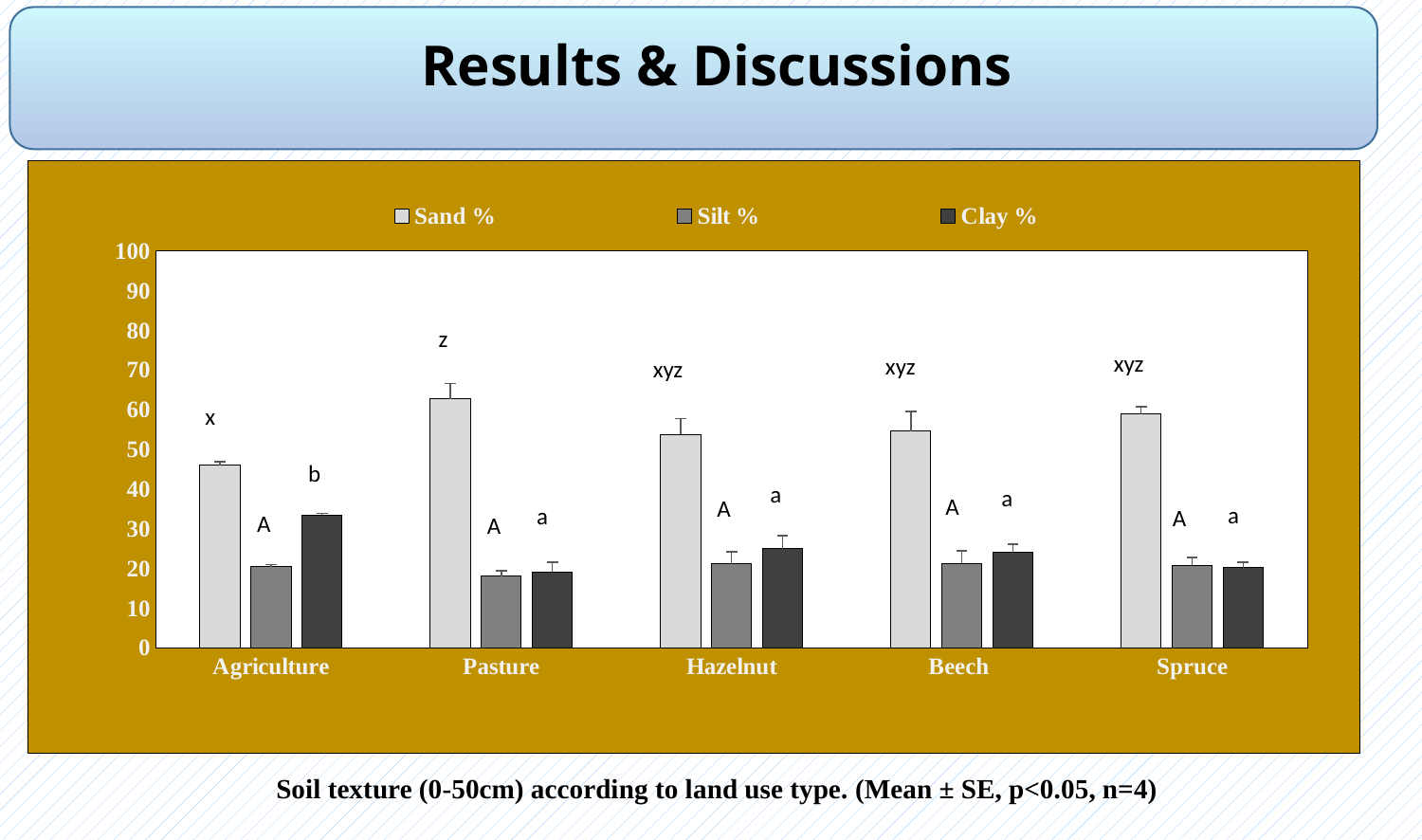
Which land use type has the lowest Sand % bar? Agriculture How many land use types are shown on the x axis of the chart? 5 Is the Sand % value for Pasture greater or less than 60? greater How many series does the chart's legend list? 3 Is the Clay % value for Agriculture greater or less than 30? greater Which land use type has the highest Sand % bar? Pasture For Agriculture, which is larger, the Silt % bar or the Clay % bar? Clay % What kind of chart is shown on the slide? bar chart Which series are listed in the chart's legend? Sand %, Silt %, Clay % Which land use type has the highest Clay % bar? Agriculture What letter is printed above the Sand % bar for Pasture? z Is the Sand % value for Agriculture greater or less than 50? less